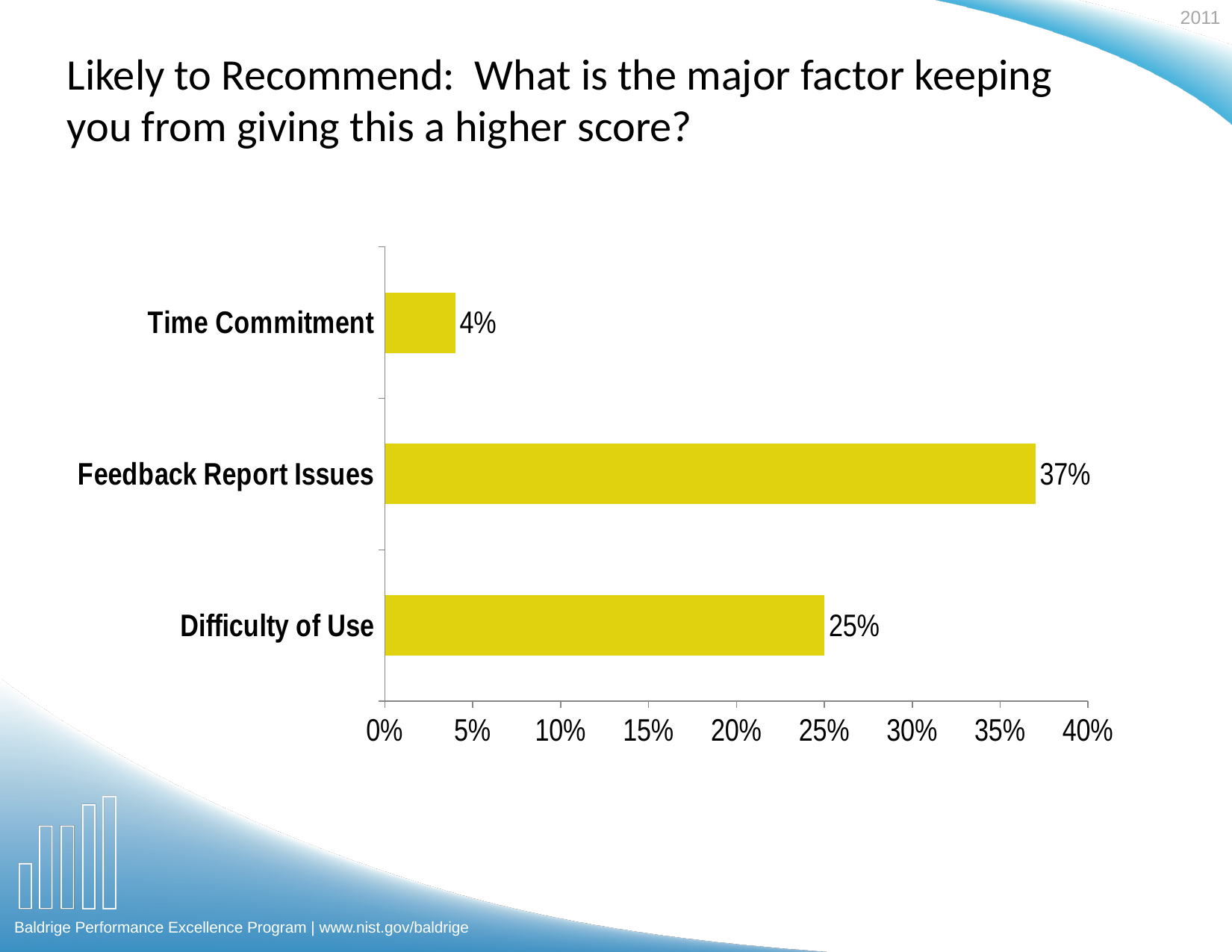
What is the difference between the values for Feedback Report Issues and Difficulty of Use? 12% Which category has the highest value? Feedback Report Issues What is the value for Difficulty of Use? 25% Is the value for Feedback Report Issues greater or less than 30%? greater Which category has the lowest value? Time Commitment What is the value for Feedback Report Issues? 37% What is the value for Time Commitment? 4% What kind of chart is shown on the slide? bar chart What is the maximum value shown on the horizontal axis? 40% How many categories are shown in the chart? 3 Which is larger, the value for Difficulty of Use or the value for Time Commitment? Difficulty of Use What is the difference between the values for Difficulty of Use and Time Commitment? 21%